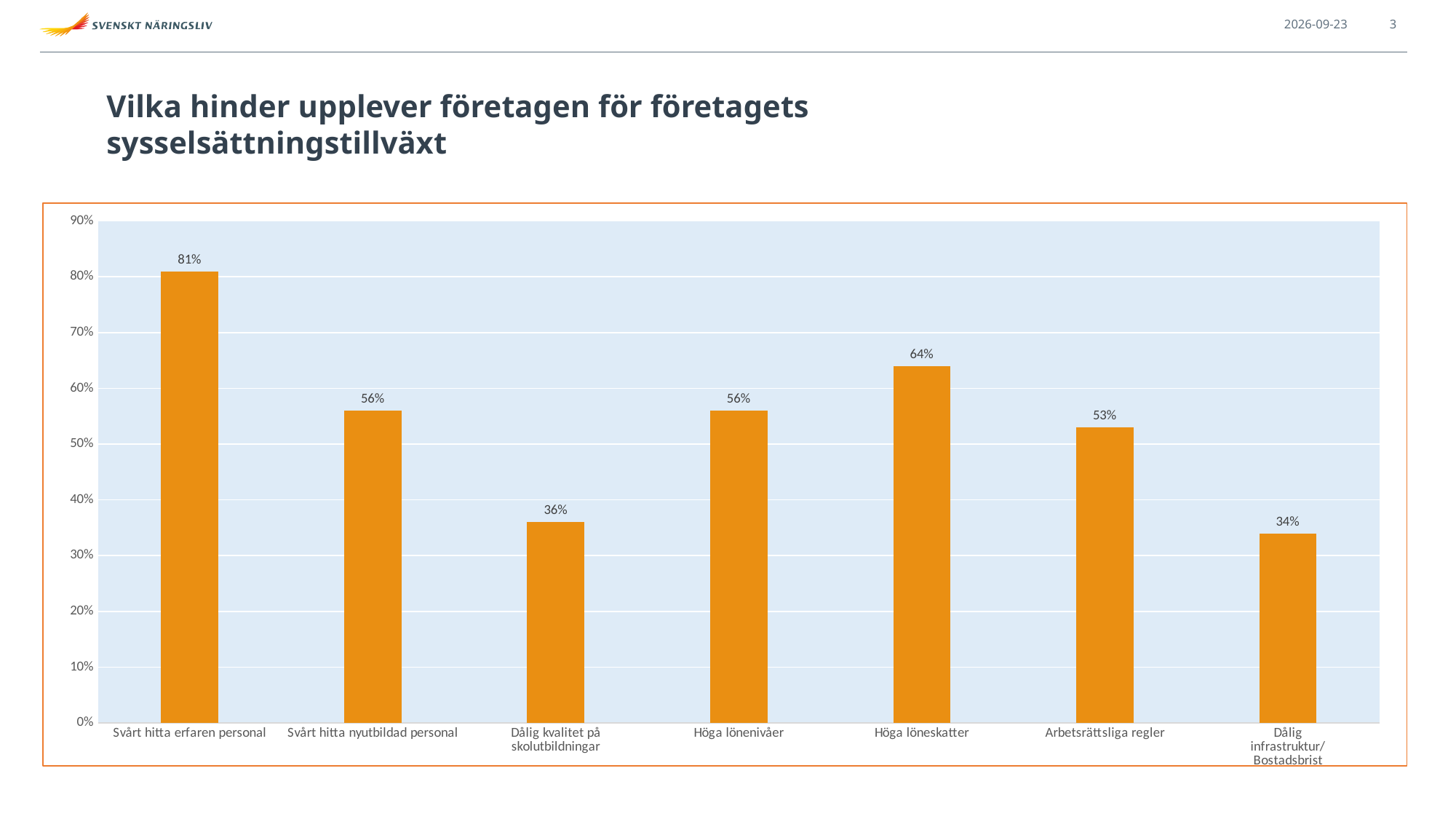
Which category has the highest value? Svårt hitta erfaren personal Which category has the lowest value? Dålig infrastruktur/Bostadsbrist What is the difference between the values for Svårt hitta erfaren personal and Höga löneskatter? 17% What kind of chart is shown on the slide? Bar chart What is the title of the slide? Vilka hinder upplever företagen för företagets sysselsättningstillväxt Which is larger, the value for Höga löneskatter or the value for Arbetsrättsliga regler? Höga löneskatter What is the value for Svårt hitta erfaren personal? 81% What is the value for Dålig kvalitet på skolutbildningar? 36% Is the value for Höga lönenivåer greater or less than 50%? greater How many categories are shown in the chart? 7 What is the value for Höga löneskatter? 64% What is the value for Arbetsrättsliga regler? 53%